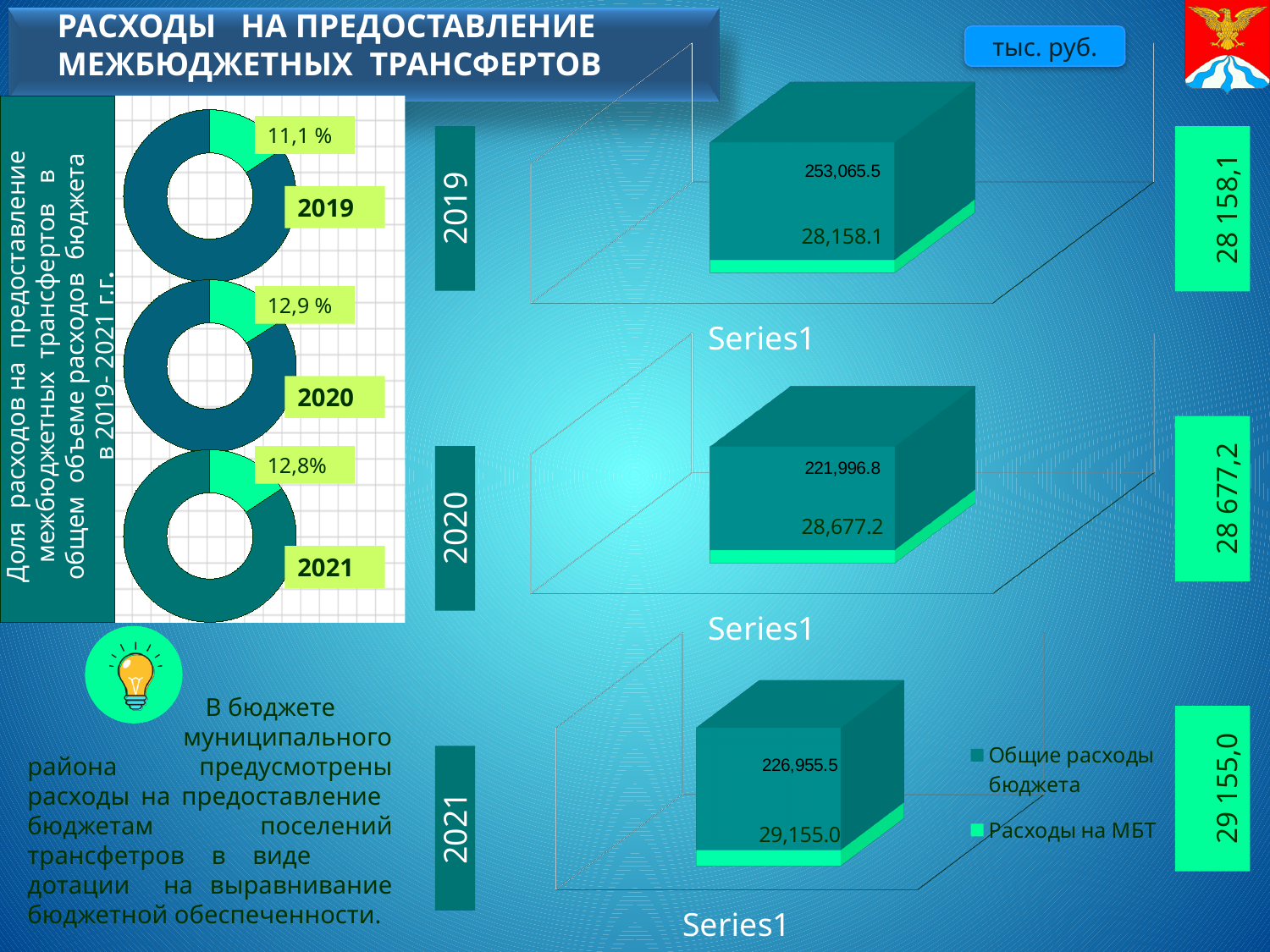
In the 2019 bar chart, what is the value for Общие расходы бюджета? 253,065.5 In the 2020 bar chart, which is larger: Общие расходы бюджета or Расходы на МБТ? Общие расходы бюджета In the 2020 bar chart, what is the difference between Общие расходы бюджета and Расходы на МБТ? 193,319.6 In the 2021 bar chart, what is the value for Общие расходы бюджета? 226,955.5 How many series does the legend of the bar charts list? 2 In the 2021 bar chart, what is the value for Расходы на МБТ? 29,155.0 In the 2019 bar chart, what is the value for Расходы на МБТ? 28,158.1 What type of chart is used for the 2019, 2020 and 2021 charts on the left side of the slide? Donut (pie) chart In the 2020 bar chart, what is the value for Общие расходы бюджета? 221,996.8 In the donut chart for 2020, what share is shown for the highlighted slice? 12,9 % In the 2019 bar chart, what is the total of the stacked bar? 281,223.6 In the donut chart for 2019, what share is shown for the highlighted slice? 11,1 %